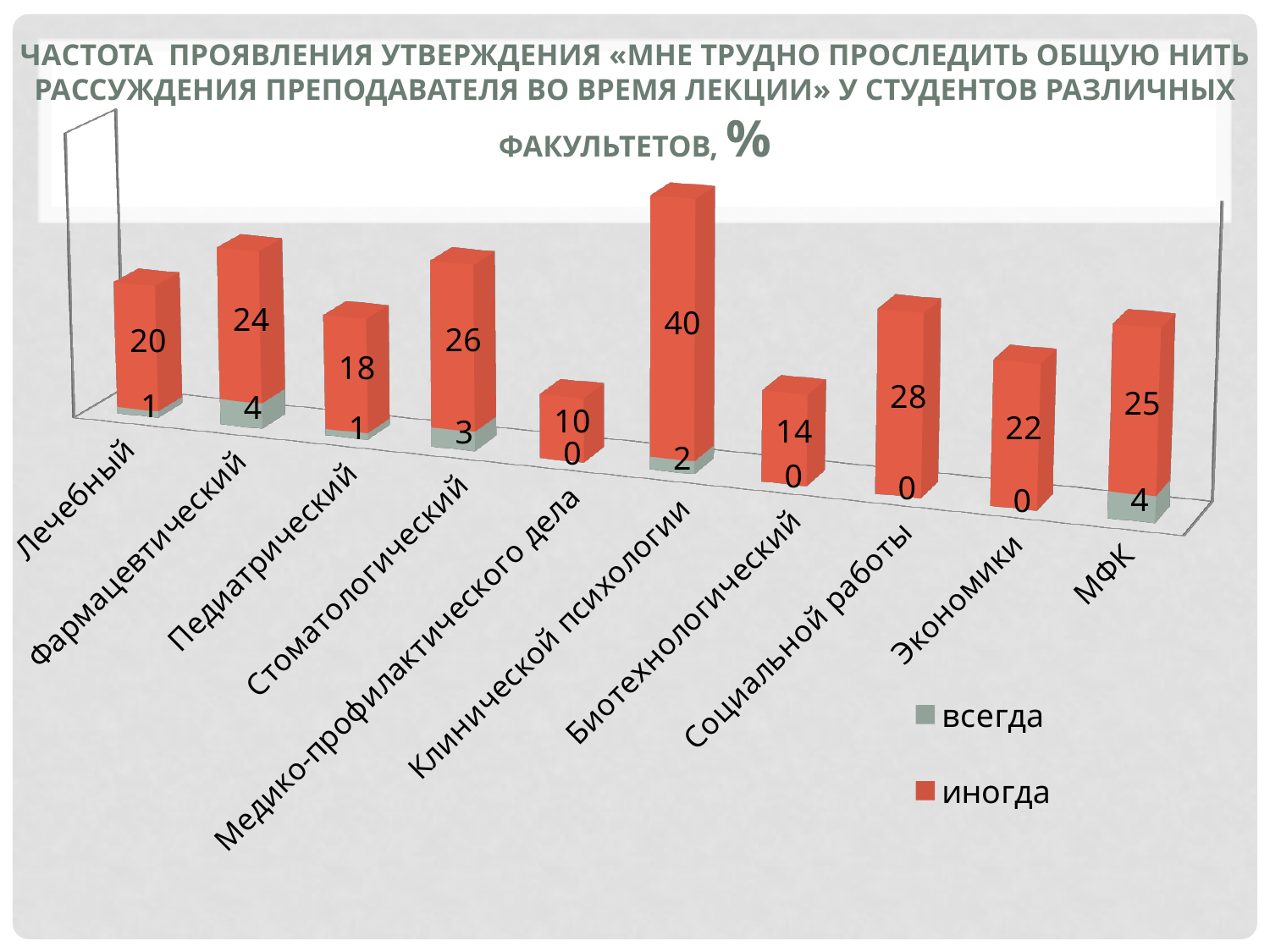
What is the difference between the «иногда» values for Социальной работы and Биотехнологический? 14 Which is larger, the «иногда» value for Экономики or for МФК? МФК What is the value of the «всегда» series for Стоматологический? 3 How many faculties are shown on the x axis? 10 Which faculty has the lowest value for the «иногда» series? Медико-профилактического дела What is the value of the «иногда» series for Клинической психологии? 40 What is the total of the stacked bar for Фармацевтический? 28 What is the value of the «иногда» series for Лечебный? 20 What is the value of the «всегда» series for Фармацевтический? 4 Which faculty has the highest value for the «иногда» series? Клинической психологии How many series does the legend list? 2 What kind of chart is shown on the slide? Stacked bar chart